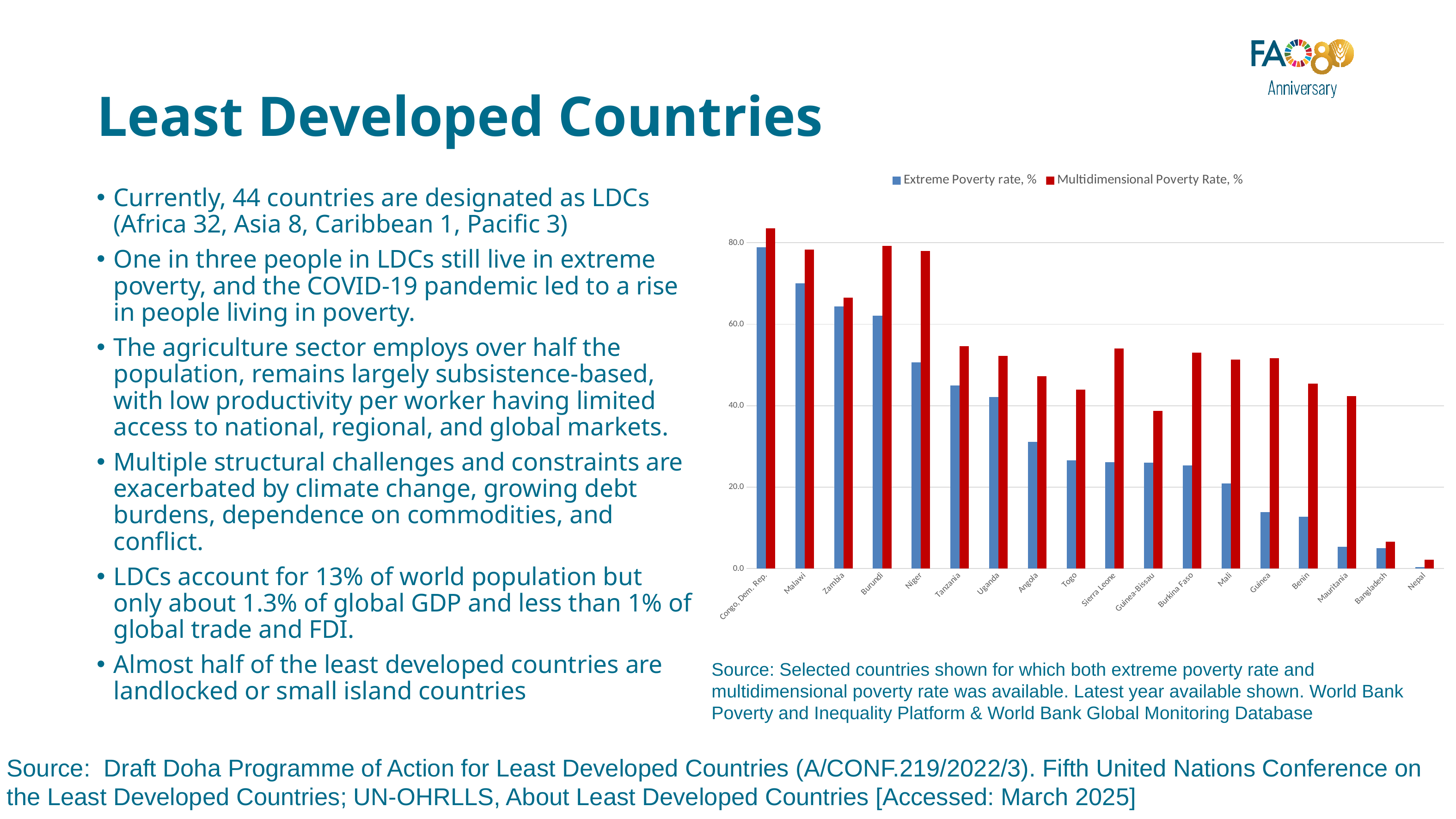
Is the Extreme Poverty rate, % for Angola greater or less than 40.0? less Which country has the highest Extreme Poverty rate, % in the chart? Congo, Dem. Rep. Which colour represents the Multidimensional Poverty Rate, % series in the chart? red Which is larger for Mauritania: the Extreme Poverty rate, % or the Multidimensional Poverty Rate, %? Multidimensional Poverty Rate, % How many countries are shown on the x axis of the chart? 18 Which country has the lowest Multidimensional Poverty Rate, % in the chart? Nepal What kind of chart is shown on the slide? bar chart How many series does the chart's legend list? 2 Does the Extreme Poverty rate, % generally rise or fall moving from left to right along the x axis? fall Is the Extreme Poverty rate, % for Malawi greater or less than 60.0? greater Is the Multidimensional Poverty Rate, % for Congo, Dem. Rep. greater or less than 80.0? greater